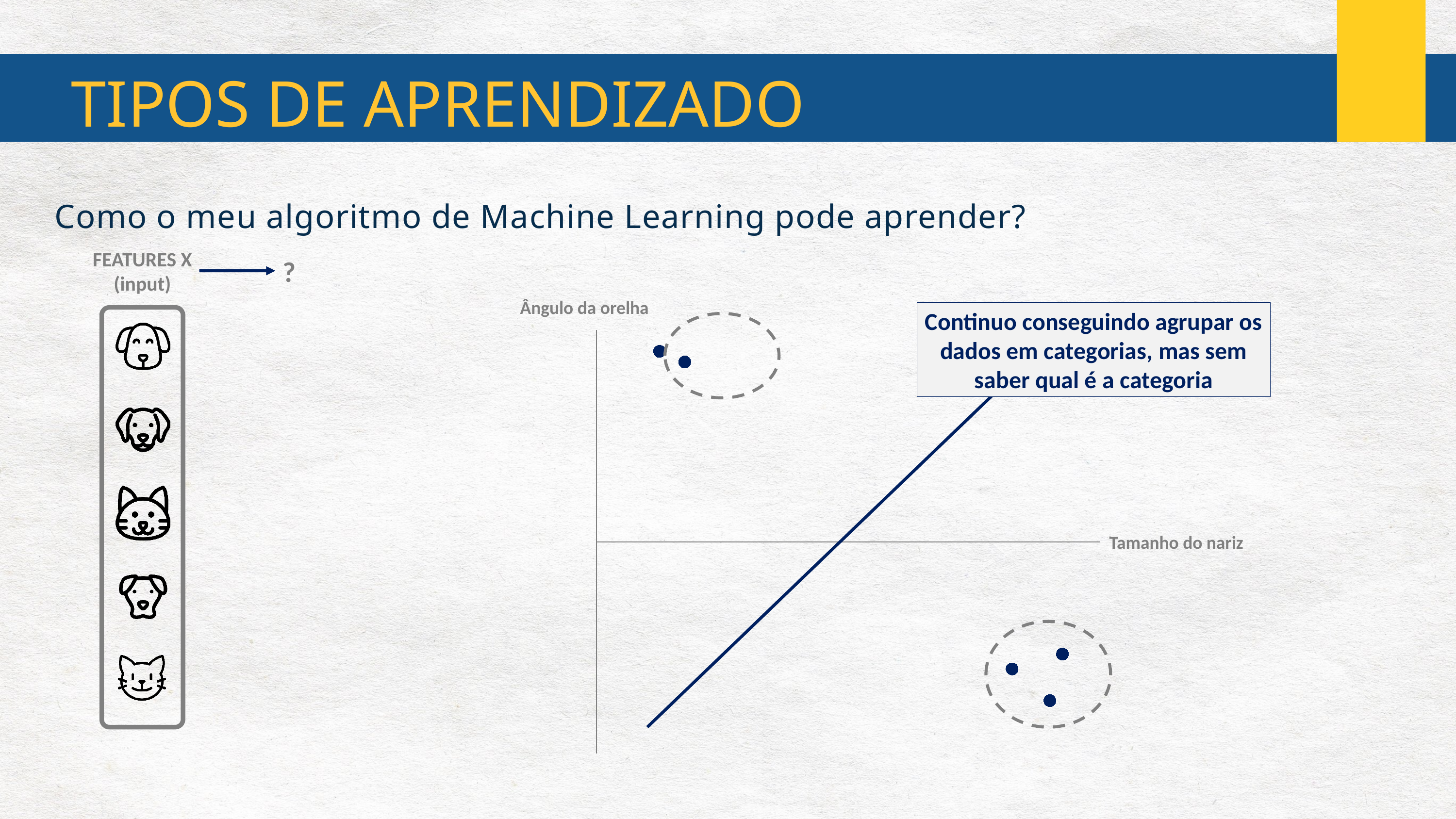
What kind of chart is shown on the slide? scatter plot Which cluster contains more points, the upper-left one or the lower-right one? the lower-right one How many data points are plotted on the chart? 5 How many points are inside the upper-left dashed cluster on the chart? 2 How many dashed-circle groups (clusters) are drawn around the points on the chart? 2 What is the label of the vertical axis of the chart? Ângulo da orelha What is the label of the horizontal axis of the chart? Tamanho do nariz